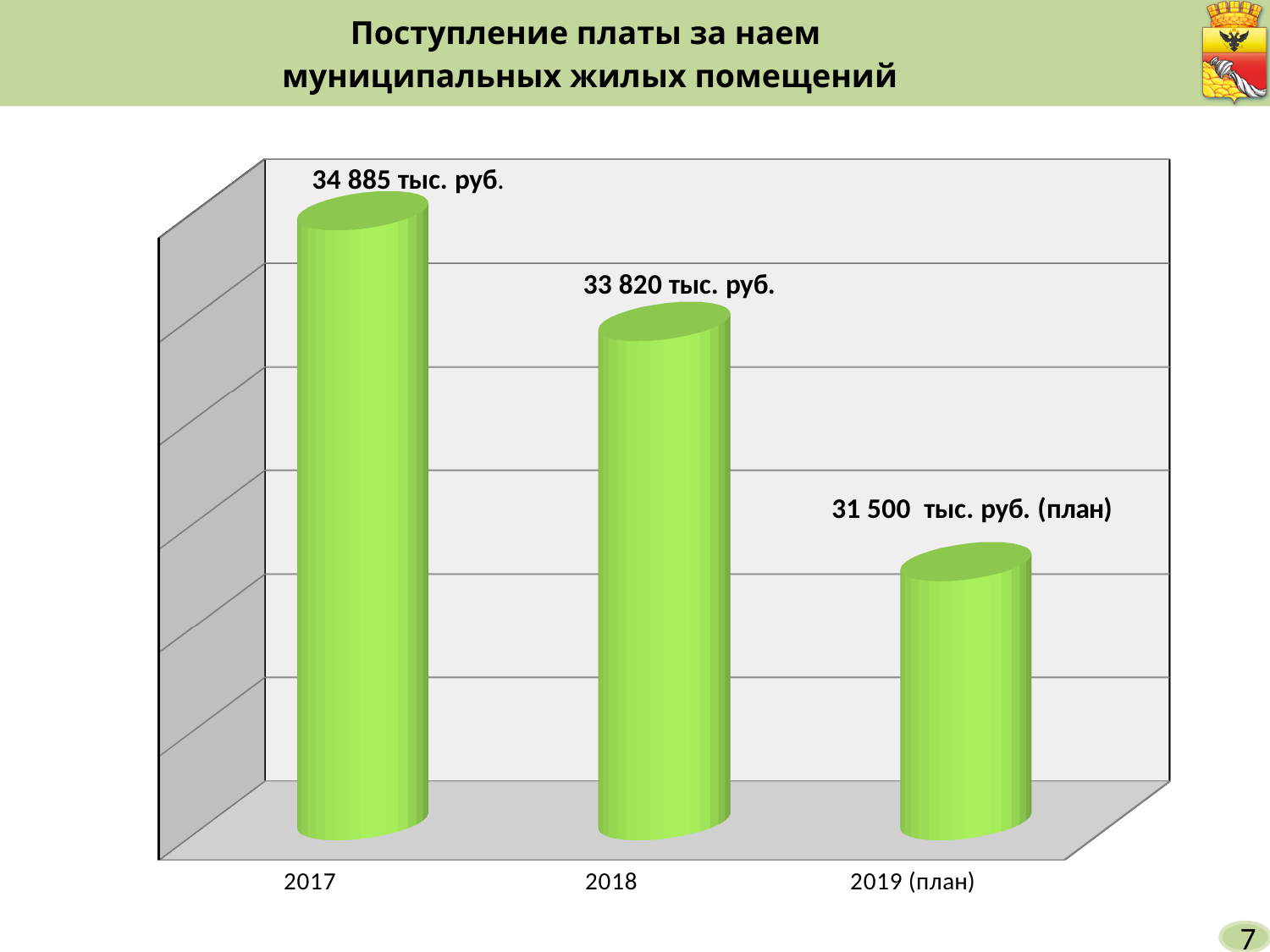
What is the value shown for 2018? 33 820 тыс. руб. Do the values rise or fall from 2017 to 2019 (план)? Fall Which year has the highest value? 2017 What is the difference between the values for 2017 and 2019 (план)? 3 385 тыс. руб. Which is larger, the value for 2018 or the value for 2019 (план)? 2018 What is the difference between the values for 2018 and 2019 (план)? 2 320 тыс. руб. Which category has the lowest value? 2019 (план) What is the value shown for 2017? 34 885 тыс. руб. What is the difference between the values for 2017 and 2018? 1 065 тыс. руб. What kind of chart is shown on the slide? Bar chart How many categories are shown on the chart? 3 What is the planned value shown for 2019 (план)? 31 500 тыс. руб.